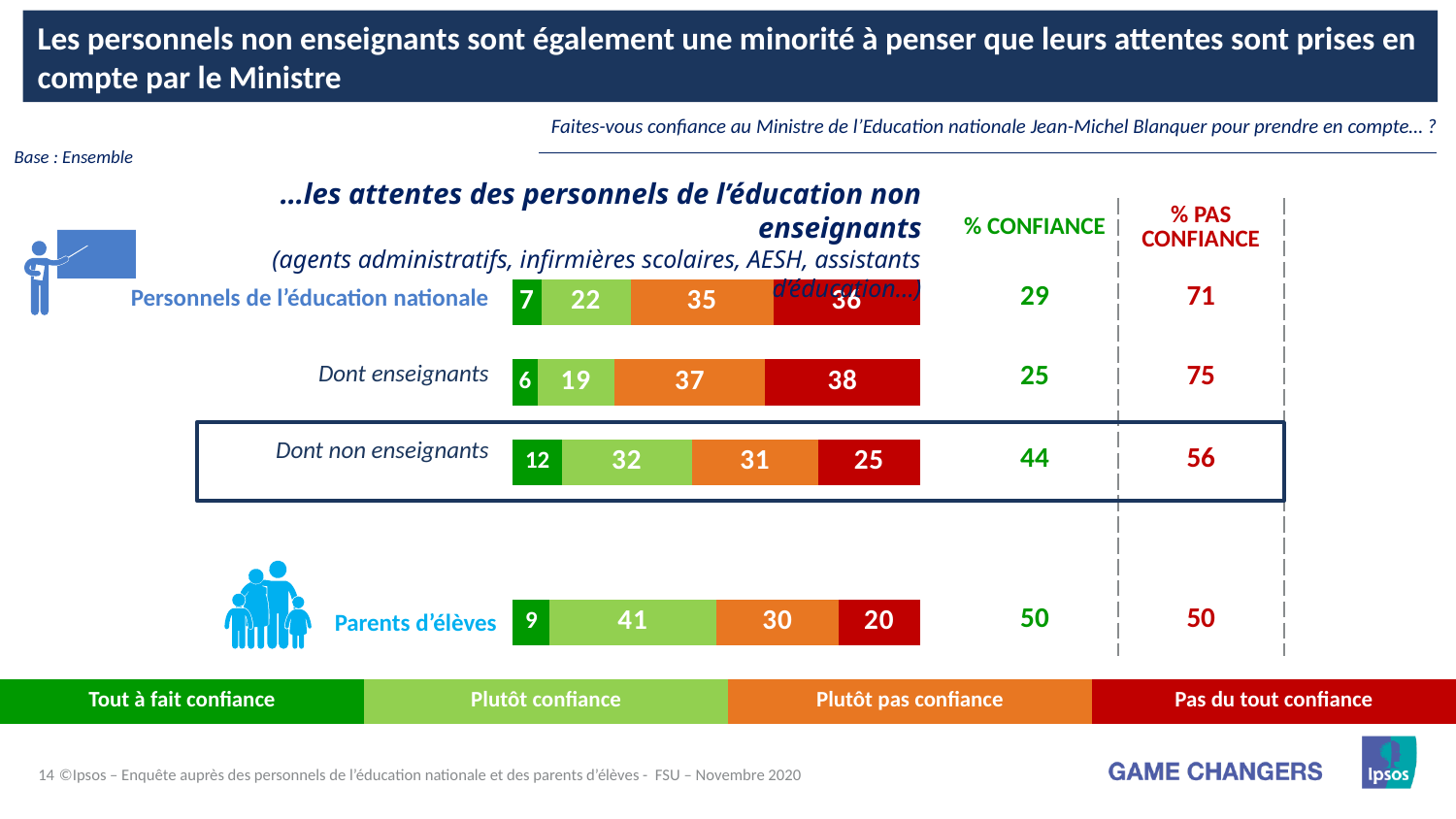
What is the '% CONFIANCE' value for 'Personnels de l'éducation nationale'? 29 How many categories (rows) are plotted in the chart? 4 What is the total of the stacked bar for 'Parents d'élèves'? 100 Which category has the lowest '% CONFIANCE' value? Dont enseignants Which is larger: the 'Plutôt confiance' value for 'Dont non enseignants' or for 'Dont enseignants'? Dont non enseignants How many series does the legend at the bottom list? 4 What kind of chart is shown on the slide? Stacked bar chart What is the 'Tout à fait confiance' value for 'Dont non enseignants'? 12 Which category has the highest 'Pas du tout confiance' value? Dont enseignants What is the difference between the '% PAS CONFIANCE' values for 'Dont enseignants' and 'Dont non enseignants'? 19 What is the 'Plutôt confiance' value for 'Parents d'élèves'? 41 What is the 'Pas du tout confiance' value for 'Dont enseignants'? 38